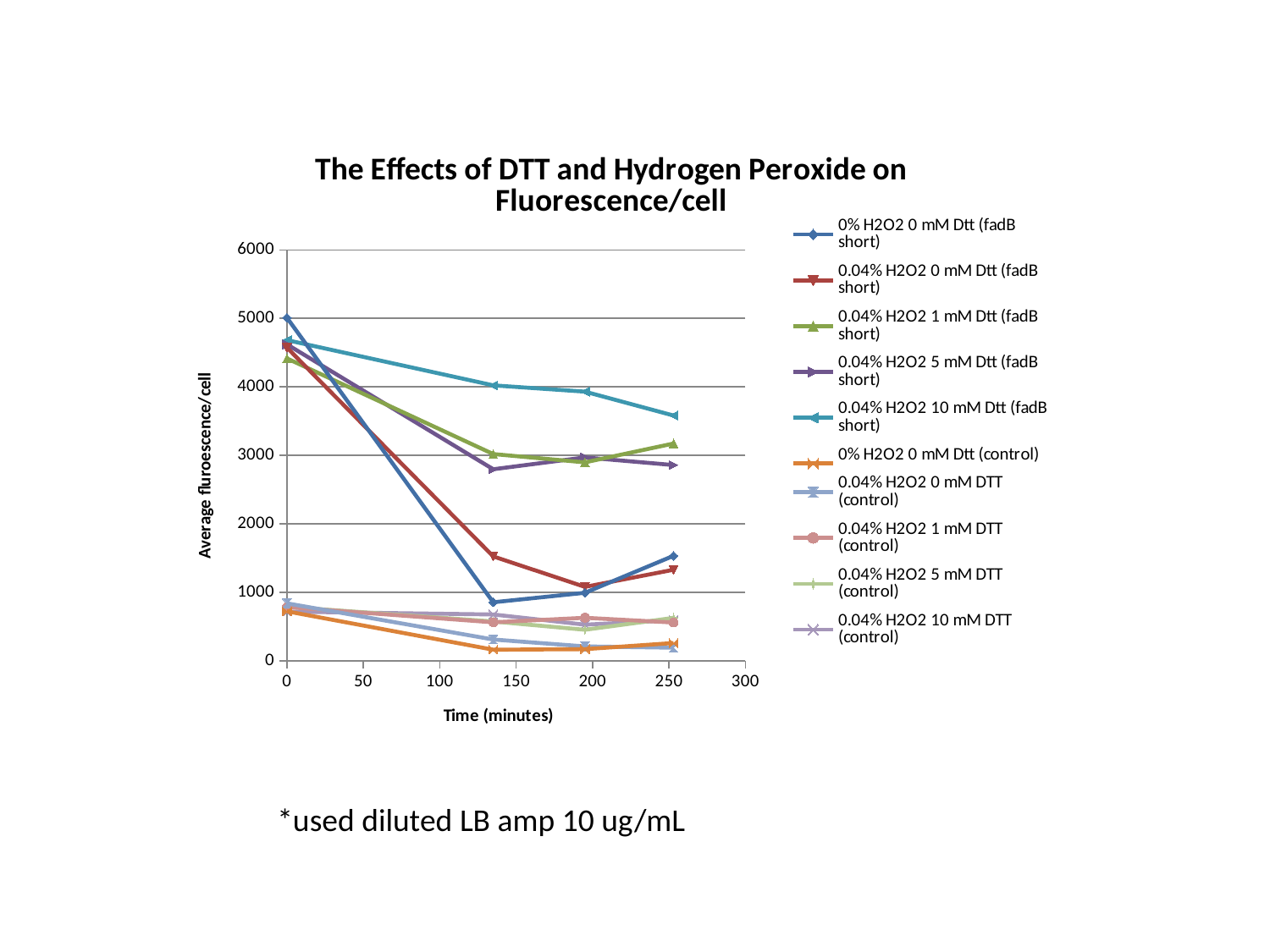
Does the 0.04% H2O2 10 mM Dtt (fadB short) series rise or fall over time? fall Is the value for 0% H2O2 0 mM Dtt (fadB short) at the second time point (around 135 minutes) greater or less than 1000? less Is the value for 0.04% H2O2 0 mM Dtt (fadB short) at the second time point (around 135 minutes) greater or less than 1000? greater Is the value for 0.04% H2O2 10 mM Dtt (fadB short) at the last time point greater or less than 3000? greater What is the title of the chart? The Effects of DTT and Hydrogen Peroxide on Fluorescence/cell How many time points are plotted for each series? 4 How many series does the legend list? 10 At the last time point, which is larger: 0.04% H2O2 10 mM Dtt (fadB short) or 0.04% H2O2 5 mM Dtt (fadB short)? 0.04% H2O2 10 mM Dtt (fadB short) What kind of chart is shown on the slide? line chart Which series has the highest value at time 0? 0% H2O2 0 mM Dtt (fadB short) What is the label of the x axis? Time (minutes)